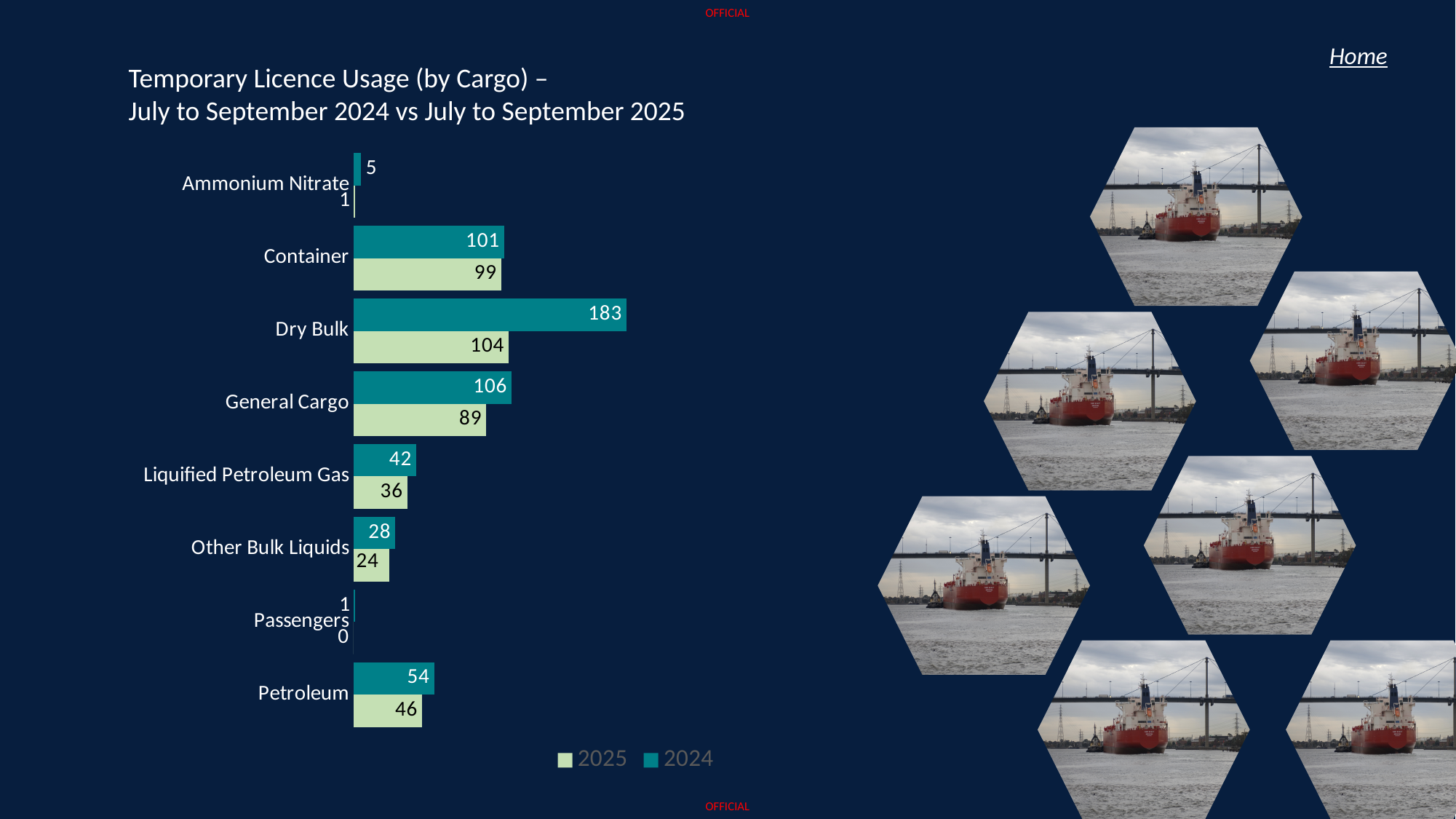
What is the 2024 value for Dry Bulk? 183 Which is larger for Liquified Petroleum Gas, the 2024 value or the 2025 value? 2024 How many series does the legend list? 2 What is the difference between the 2024 and 2025 values for Dry Bulk? 79 Which series is shown in the light green colour in the legend? 2025 Which cargo category has the highest 2024 value? Dry Bulk How many cargo categories are shown in the chart? 8 What is the 2025 value for General Cargo? 89 What is the 2024 value for Petroleum? 54 What kind of chart is shown on the slide? Bar chart Which cargo category has the lowest 2025 value? Passengers What is the 2025 value for Container? 99